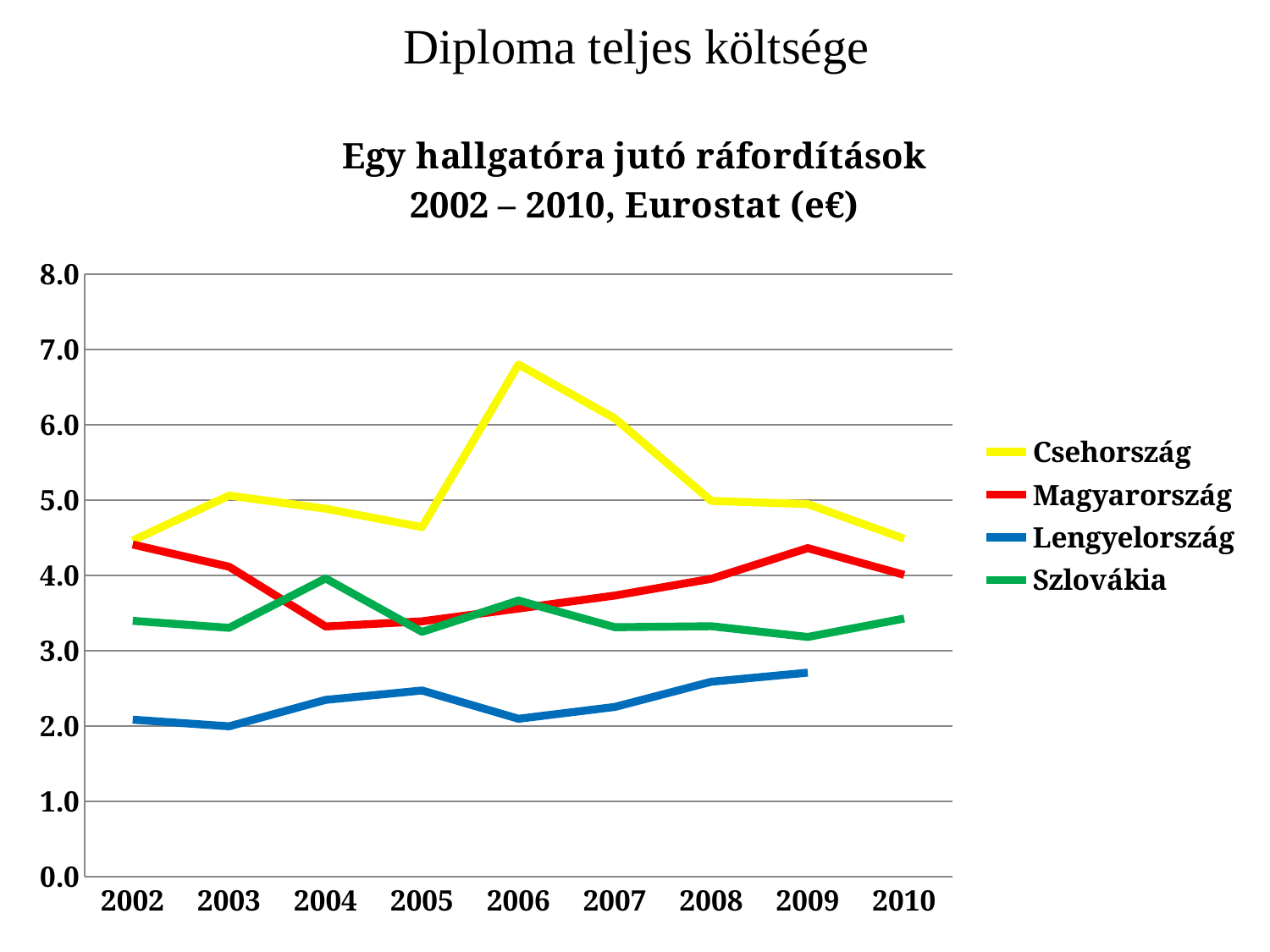
How many series does the legend list? 4 In 2004, which is larger: the value for Szlovákia or the value for Magyarország? Szlovákia What kind of chart is shown on the slide? line chart Is the value for Magyarország in 2009 greater or less than 4.0? greater Which country has the lowest value in 2002? Lengyelország How many years are shown on the x axis? 9 Which country has the highest value in 2006? Csehország What colour is the Magyarország line in the legend? red In which year does the Csehország line reach its peak? 2006 Is the value for Csehország in 2006 greater or less than 6.0? greater Is the value for Lengyelország in 2003 greater or less than 3.0? less Does the Csehország line rise or fall from 2006 to 2010? fall